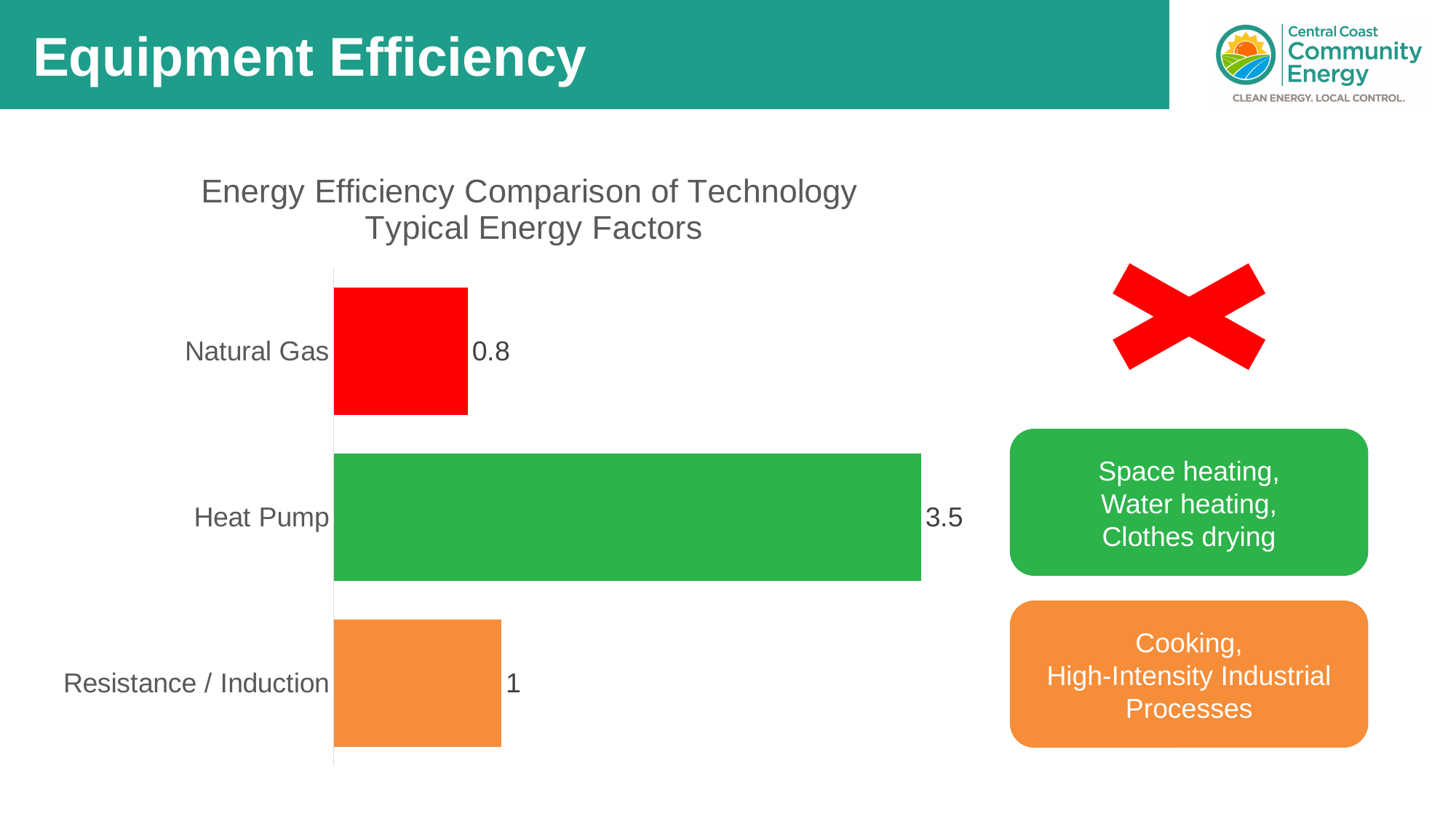
Which technology has the highest energy factor? Heat Pump What colour is the Heat Pump bar? Green How many technologies are plotted in the chart? 3 What is the typical energy factor shown for Natural Gas? 0.8 What is the difference between the energy factors of Heat Pump and Natural Gas? 2.7 What is the difference between the energy factors of Resistance / Induction and Natural Gas? 0.2 What is the typical energy factor shown for Heat Pump? 3.5 What type of chart is shown on the slide? Bar chart What is the title of the chart? Energy Efficiency Comparison of Technology Typical Energy Factors Which technology has the lowest energy factor? Natural Gas What is the typical energy factor shown for Resistance / Induction? 1 Which has a larger energy factor, Resistance / Induction or Natural Gas? Resistance / Induction